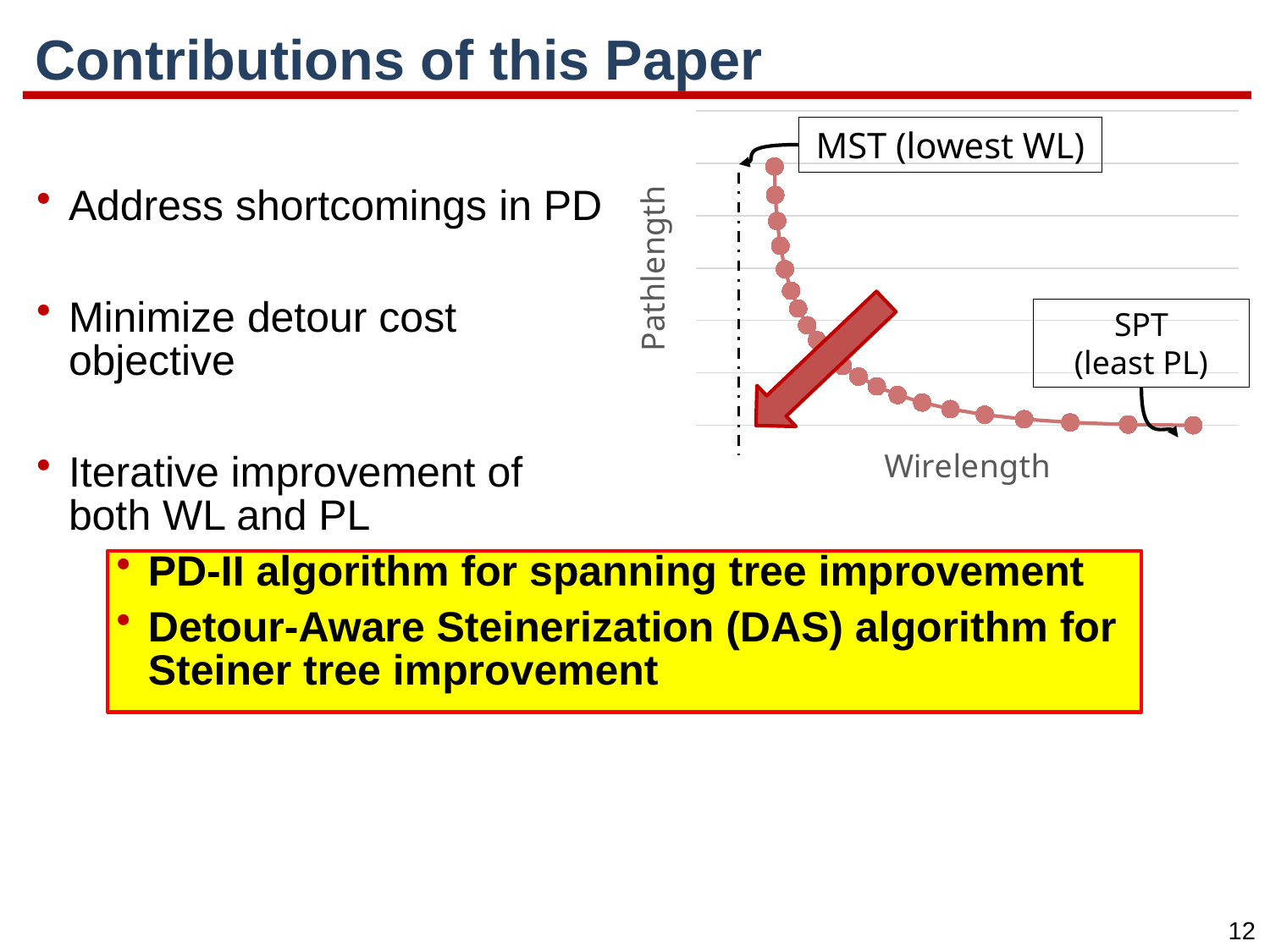
What is the label of the vertical axis of the chart? Pathlength What is the label of the horizontal axis of the chart? Wirelength What kind of chart is shown on the slide? line chart Which labelled point on the curve has the lowest wirelength? MST (lowest WL) Which labelled point on the curve has the least pathlength? SPT (least PL) Which labelled point has the larger wirelength, MST or SPT? SPT Which labelled point has the higher pathlength, MST or SPT? MST As wirelength increases along the x axis, does pathlength rise or fall? fall